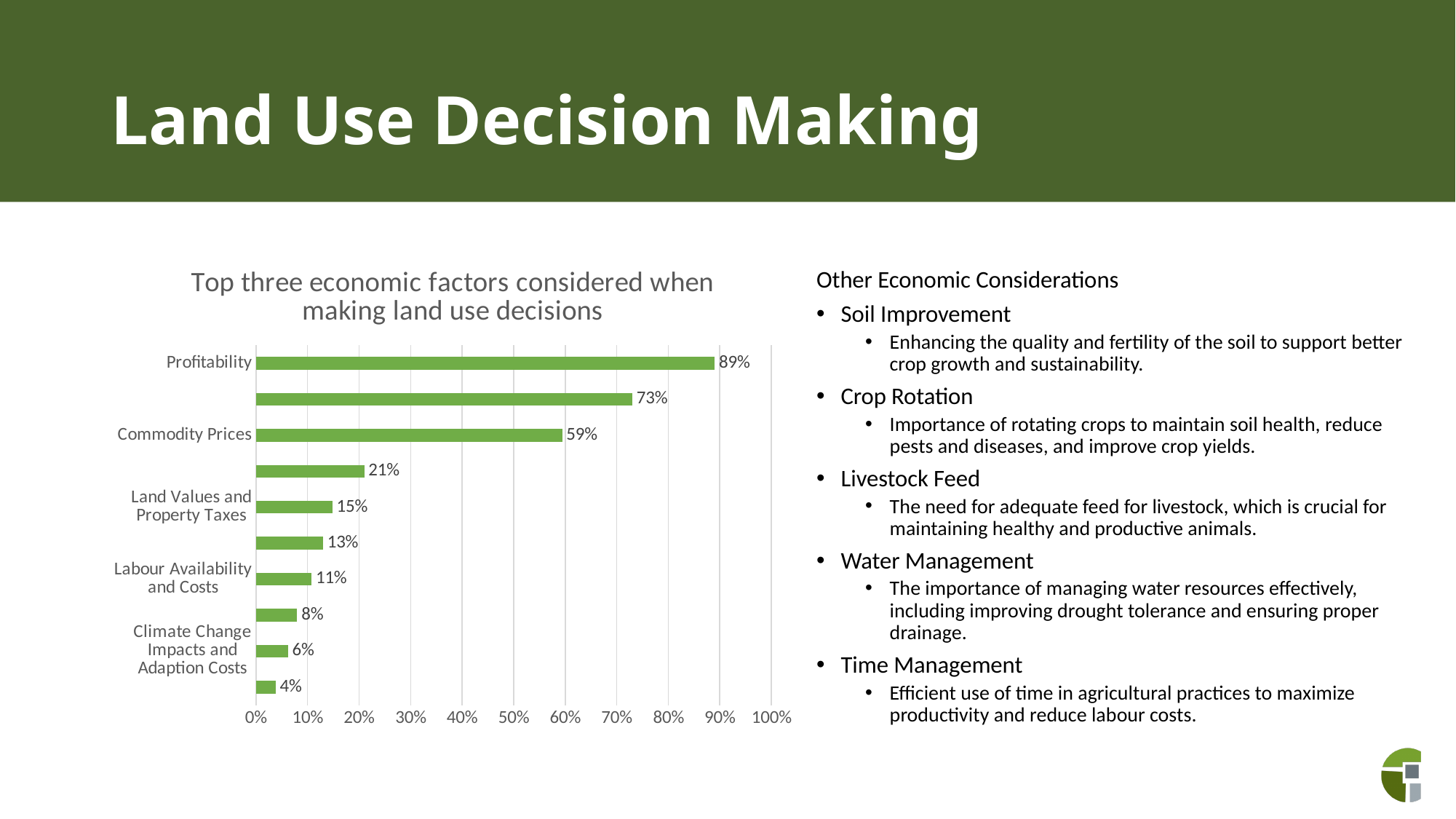
Is the value for Commodity Prices greater or less than 50%? greater What is the value for Climate Change Impacts and Adaption Costs? 6% Which is larger, the value for Land Values and Property Taxes or the value for Labour Availability and Costs? Land Values and Property Taxes Which labelled category has the highest value? Profitability What is the value for Commodity Prices? 59% How many bars are plotted in the chart? 10 What is the value for Labour Availability and Costs? 11% What kind of chart is shown on the slide? Bar chart What is the smallest value shown on any bar in the chart? 4% What is the difference between the values for Profitability and Commodity Prices? 30% What is the value for Profitability? 89% What is the value for Land Values and Property Taxes? 15%